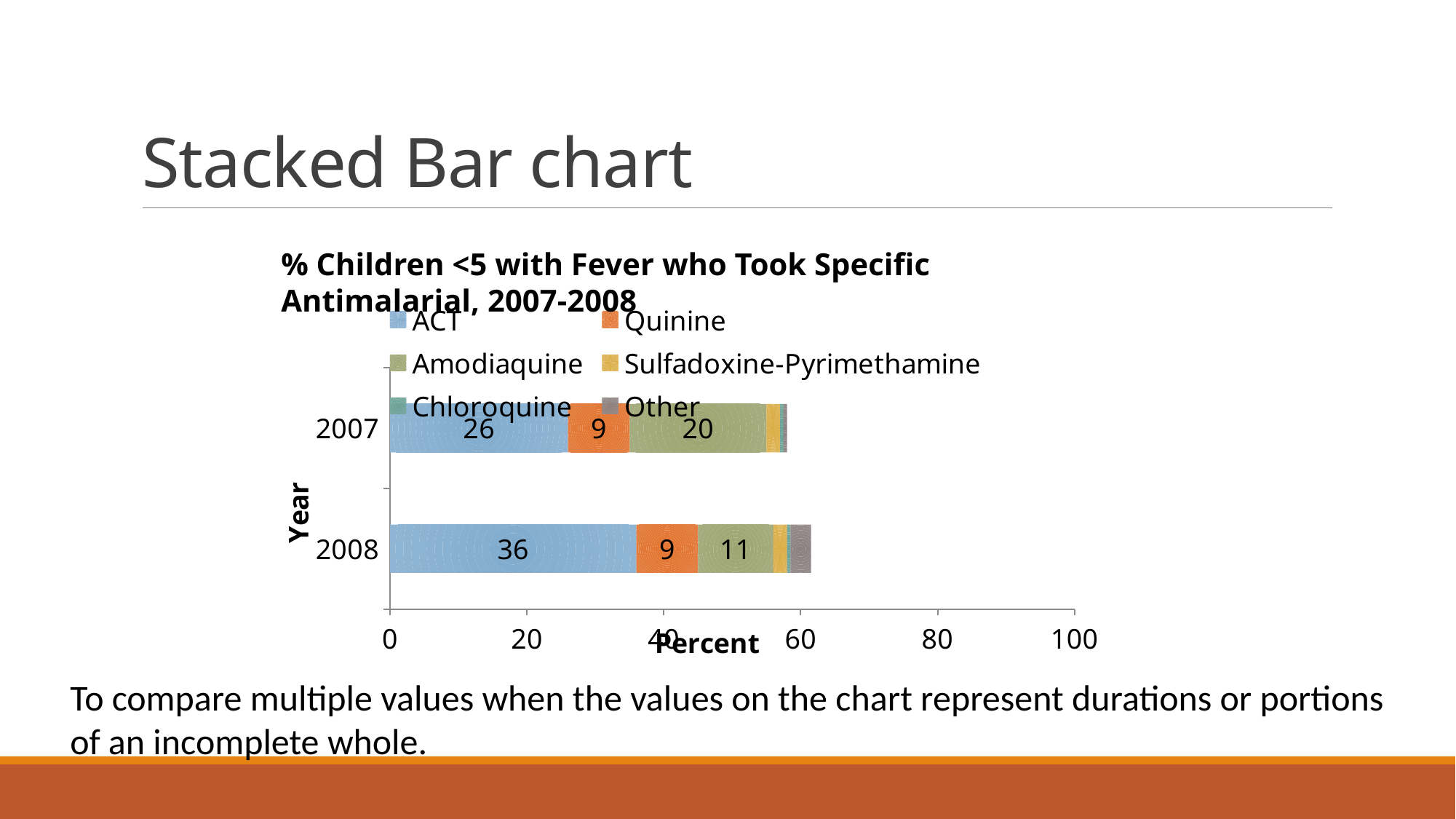
What is the value for Amodiaquine in 2008? 11 How much higher is the ACT value in 2008 than in 2007? 10 What is the value for ACT in 2007? 26 What kind of chart is shown on the slide? Stacked bar chart What is the value for Amodiaquine in 2007? 20 What is the value for Quinine in 2008? 9 What is the value for ACT in 2008? 36 Which year has the larger Amodiaquine value, 2007 or 2008? 2007 Which year has the larger ACT value, 2007 or 2008? 2008 Is the total length of the 2007 bar greater or less than 80? less What is the difference between the Amodiaquine values for 2007 and 2008? 9 How many series does the legend list? 6